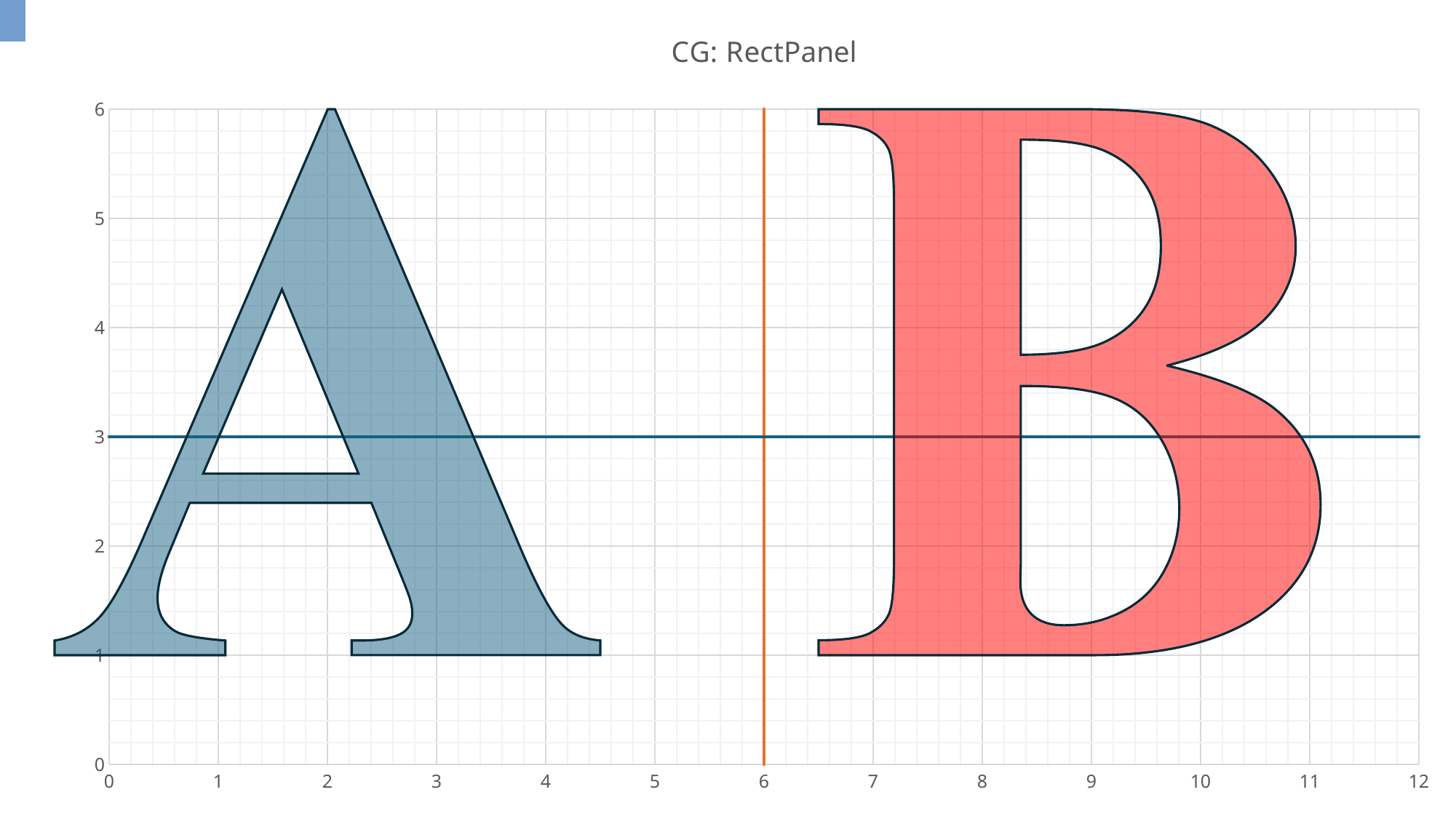
What colour is the letter B filled with? red What is the highest value shown on the y axis? 6 At what x value is the vertical orange line drawn? 6 What is the title of the chart? CG: RectPanel At what y value is the horizontal blue line drawn? 3 At what y value is the top of the letter A? 6 At what y value is the bottom of the letter B? 1 Which letter shape is positioned further to the right, A or B? B Is the rightmost x value of the letter A greater or less than 5? less Is the leftmost x value of the letter B greater or less than 6? greater How many letter shapes are drawn on the chart? 2 What is the highest value shown on the x axis? 12